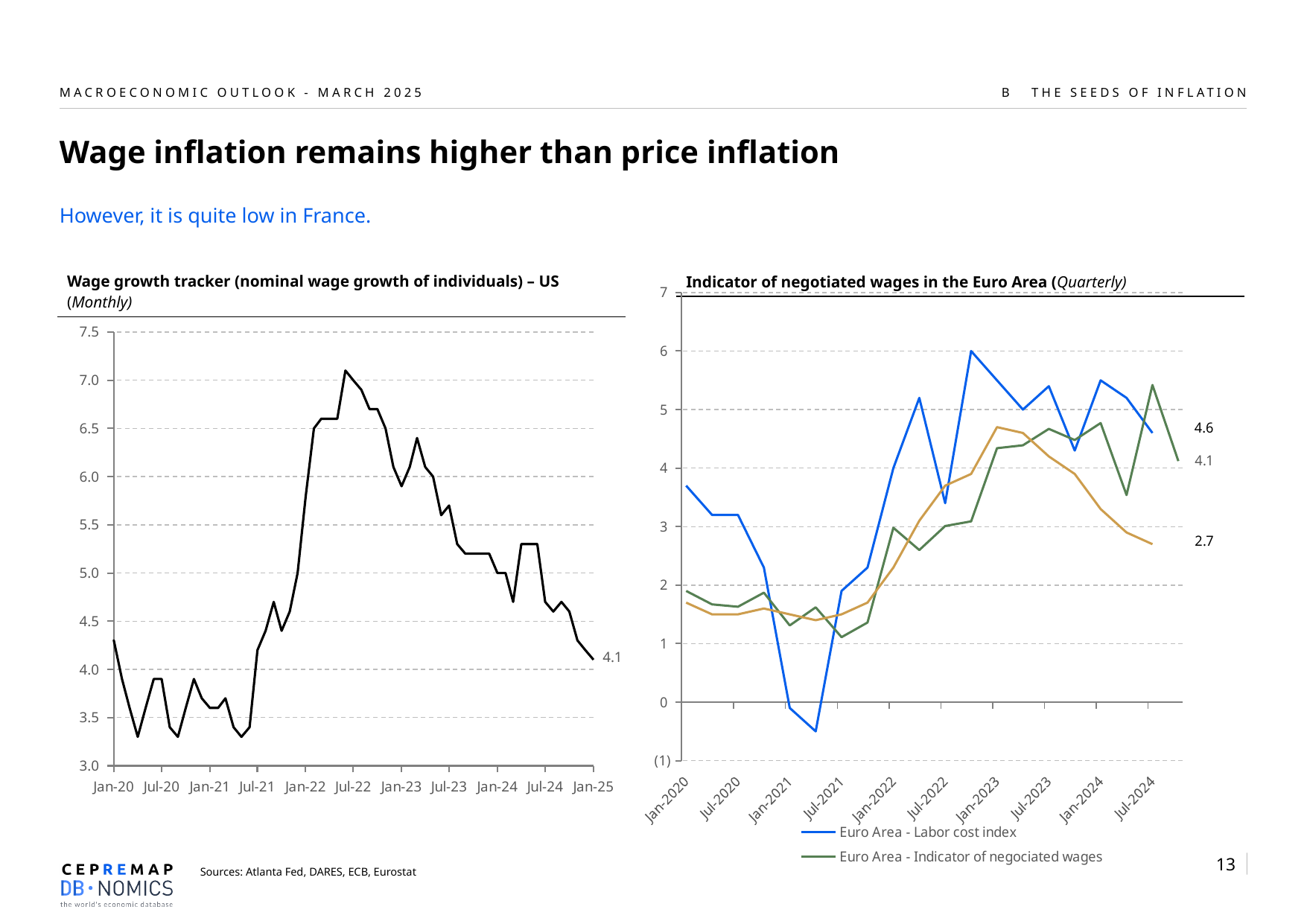
In the right chart (Euro Area), what is the final labelled value of the 'Euro Area - Labor cost index' series? 4.6 In the left chart (US wage growth tracker), is the highest value of the series greater or less than 6.5? greater In the right chart (Euro Area), what is the final labelled value of the 'Euro Area - Indicator of negociated wages' series? 4.1 In the left chart (US wage growth tracker), what is the value labelled at the end of the series in Jan-25? 4.1 In the left chart (US wage growth tracker), is the value at Jan-20 greater or less than 4.0? greater In the right chart (Euro Area), what is the difference between the final labelled values of the Labor cost index (4.6) and the Indicator of negociated wages (4.1)? 0.5 In the right chart (Euro Area), is the peak value of the 'Euro Area - Labor cost index' series greater or less than 5? greater In the right chart (Euro Area), which series ends at a higher labelled value: the Labor cost index or the Indicator of negociated wages? Euro Area - Labor cost index In the left chart (US wage growth tracker), does the series rise or fall between Jul-22 and Jan-25? Fall What kind of chart is the left chart, 'Wage growth tracker (nominal wage growth of individuals) – US'? Line chart How many series does the legend of the right chart ('Indicator of negotiated wages in the Euro Area') list? 2